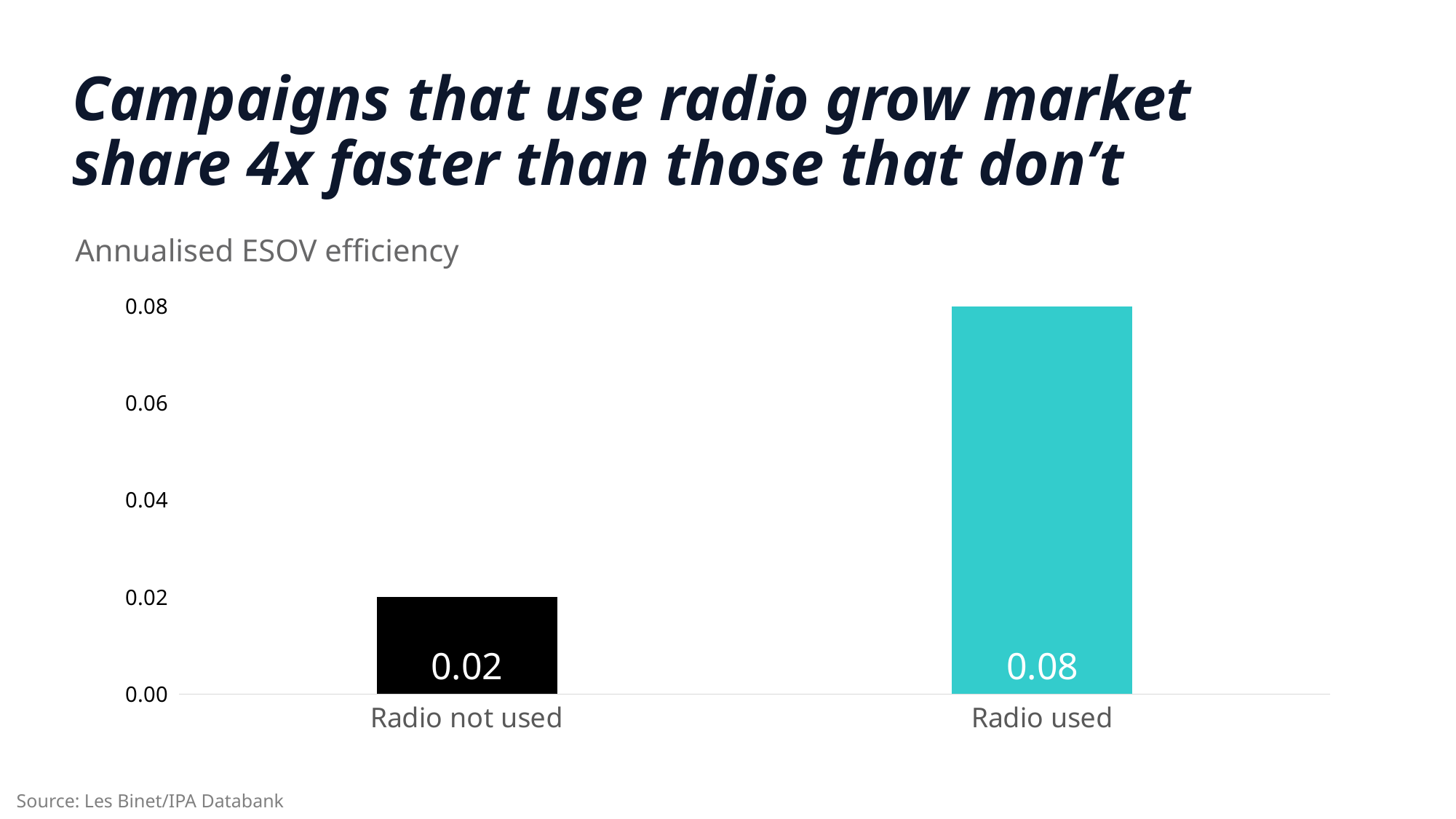
What kind of chart is shown on the slide? Bar chart What is the subtitle or axis label describing the measure plotted on the chart? Annualised ESOV efficiency What is the annualised ESOV efficiency for Radio used? 0.08 How many categories are shown on the chart? 2 What colour is the bar for Radio used? Teal Which is larger, the value for Radio used or the value for Radio not used? Radio used Which category has the lowest annualised ESOV efficiency? Radio not used Which category has the highest annualised ESOV efficiency? Radio used Is the value for Radio not used greater or less than 0.04? less What is the annualised ESOV efficiency for Radio not used? 0.02 Is the value for Radio used greater or less than 0.06? greater What is the difference in annualised ESOV efficiency between Radio used and Radio not used? 0.06